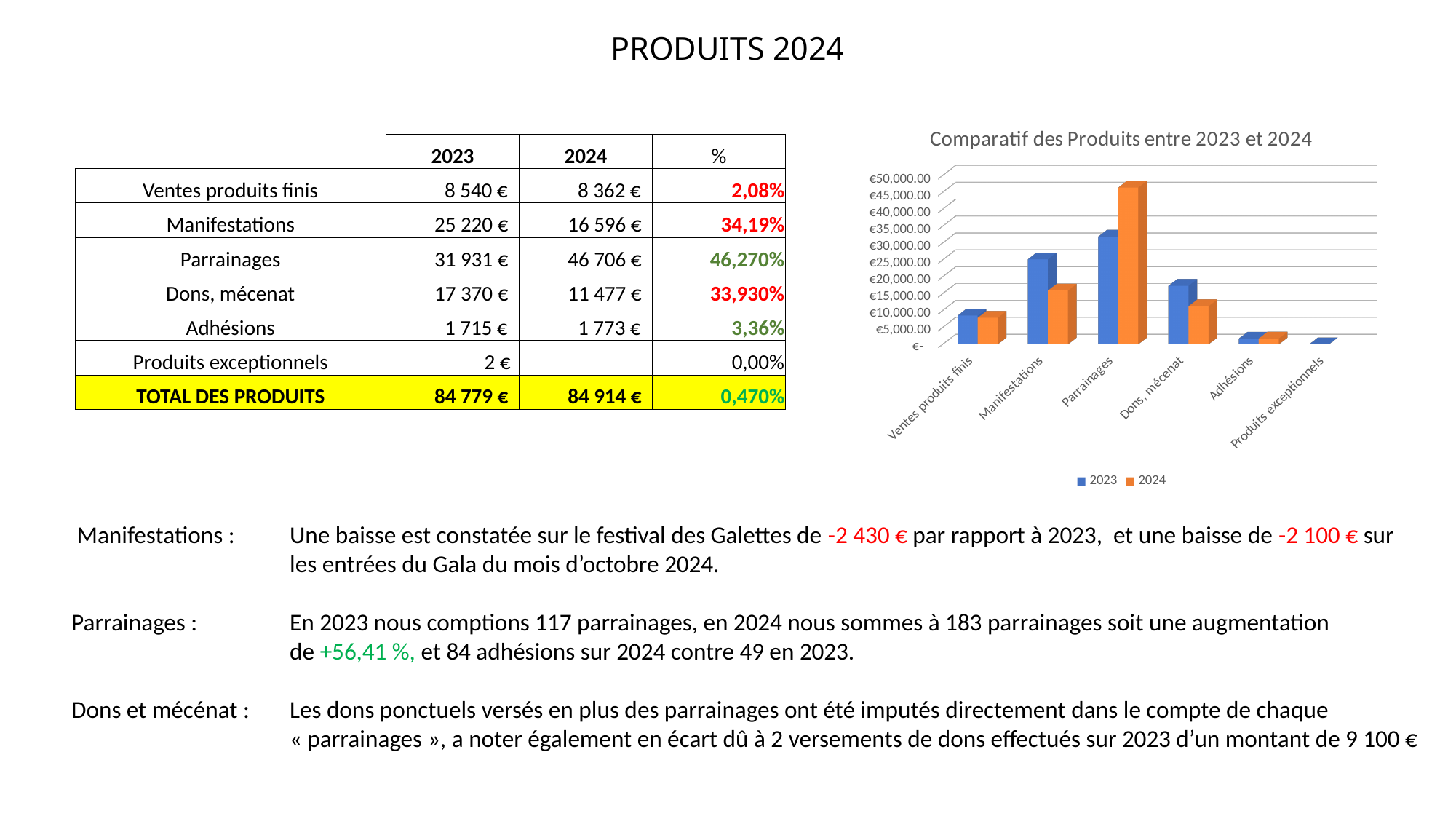
Which category has the highest 2024 value in the chart? Parrainages Is the 2024 value for Parrainages greater or less than €40,000.00? greater For Parrainages, which year has the larger value, 2023 or 2024? 2024 How many categories are shown on the x axis of the chart? 6 Which category has the highest 2023 value in the chart? Parrainages Which category has the lowest 2023 value in the chart? Produits exceptionnels How many series does the chart legend list? 2 What is the title of the chart? Comparatif des Produits entre 2023 et 2024 What colour represents the 2024 series in the chart? orange For Manifestations, which year has the larger value, 2023 or 2024? 2023 Is the 2023 value for Manifestations greater or less than €20,000.00? greater What kind of chart is shown on the slide? bar chart